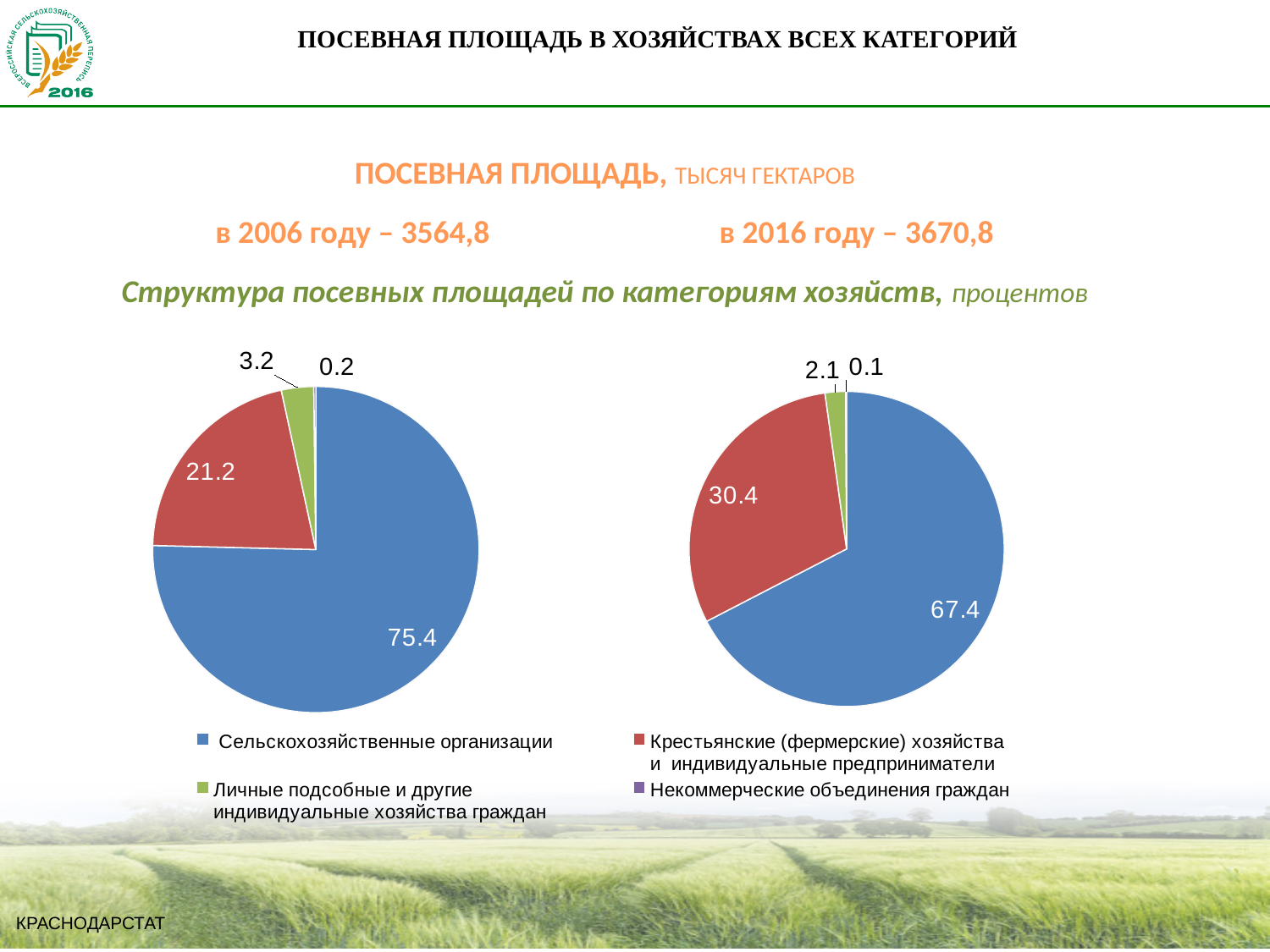
In the left pie chart (2006), what is the share for Личные подсобные и другие индивидуальные хозяйства граждан? 3.2 How many slices does the left pie chart (2006) have? 4 How many categories does the legend list? 4 Which colour represents Сельскохозяйственные организации in the pie charts? Blue In the right pie chart (2016), what is the share for Крестьянские (фермерские) хозяйства и индивидуальные предприниматели? 30.4 In the right pie chart (2016), which category has the largest share? Сельскохозяйственные организации In the left pie chart (2006), what is the share for Сельскохозяйственные организации? 75.4 In the right pie chart (2016), what is the share for Некоммерческие объединения граждан? 0.1 Is the share of Крестьянские (фермерские) хозяйства larger in the 2006 chart or in the 2016 chart? 2016 What is the difference between the share of Сельскохозяйственные организации in the 2006 chart and in the 2016 chart? 8.0 What type of chart is used on this slide? Pie chart In the left pie chart (2006), which category has the smallest share? Некоммерческие объединения граждан